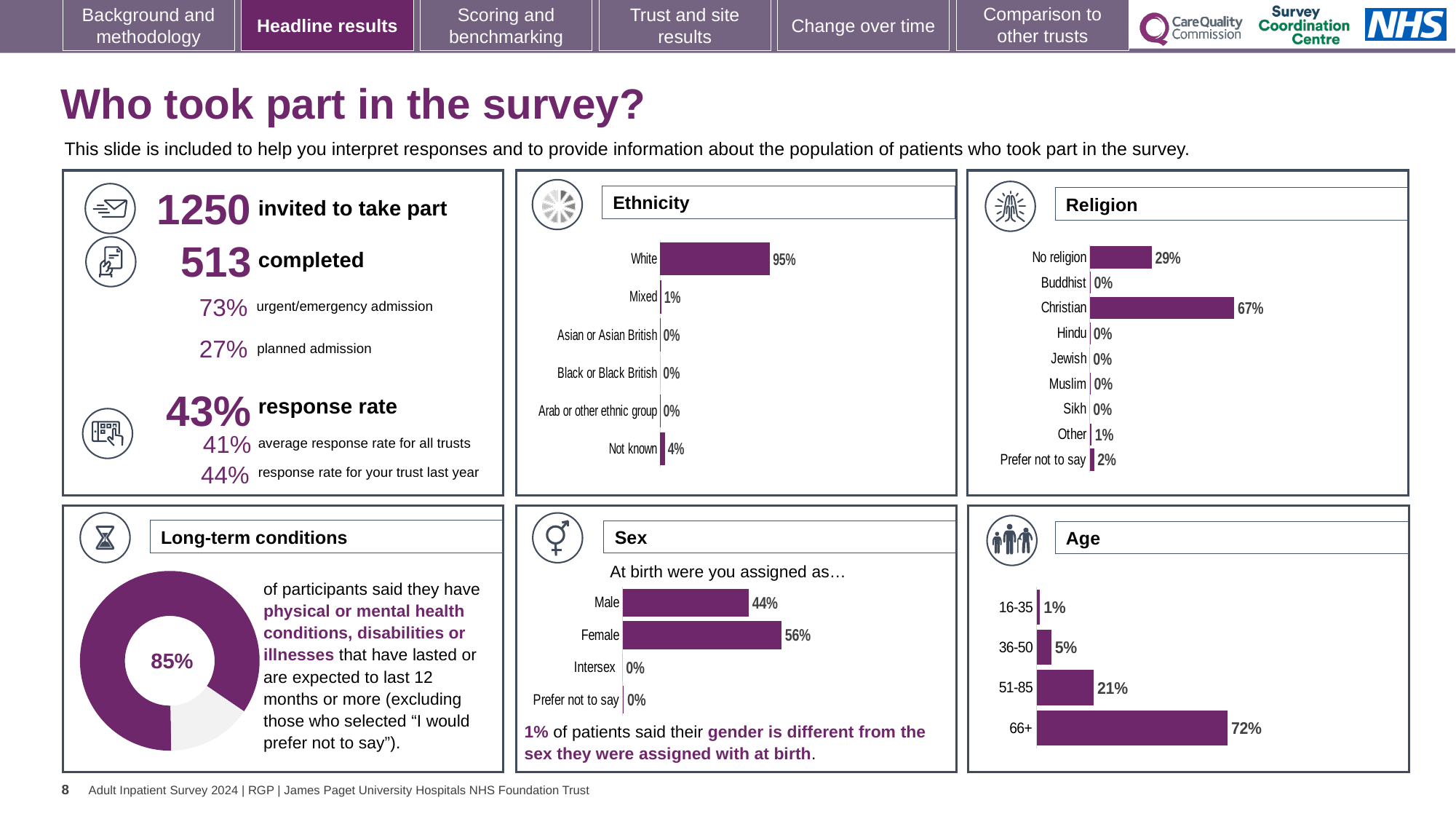
In the Ethnicity chart, what percentage of participants were Not known? 4% In the Age chart, do the values rise or fall as the age groups get older? rise In the Age chart, what percentage of participants were aged 51-85? 21% How many categories are shown in the Religion chart? 9 In the Ethnicity chart, what percentage of participants were White? 95% In the Religion chart, what percentage of participants said No religion? 29% In the Religion chart, what is the difference between Christian and No religion? 38 percentage points In the Age chart, which age group has the lowest value? 16-35 In the Sex chart, what is the difference between Female and Male? 12 percentage points What kind of chart is the Long-term conditions chart? doughnut chart In the Sex chart, which is larger, Male or Female? Female In the Religion chart, which category has the highest value? Christian